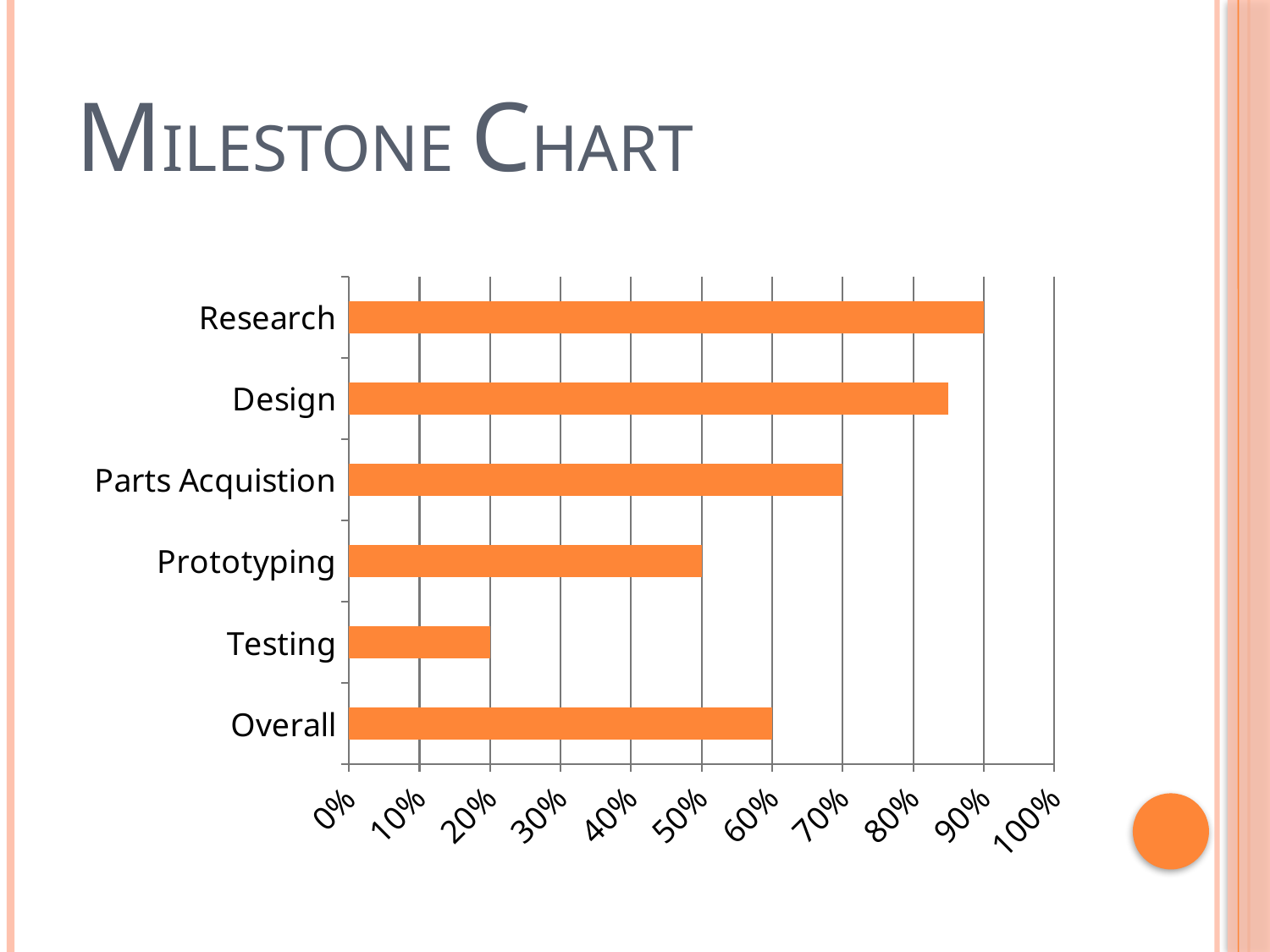
What is the value for Parts Acquistion? 70% Which category has the lowest value? Testing How many categories are plotted in the chart? 6 What is the value for Testing? 20% Is the value for Design greater or less than 80%? greater What kind of chart is shown on the slide? bar chart Which category has the highest value? Research Which is larger, the value for Prototyping or the value for Overall? Overall What is the value for Research? 90% What is the value for Prototyping? 50% What is the title of the slide's chart? Milestone Chart What is the value for Overall? 60%